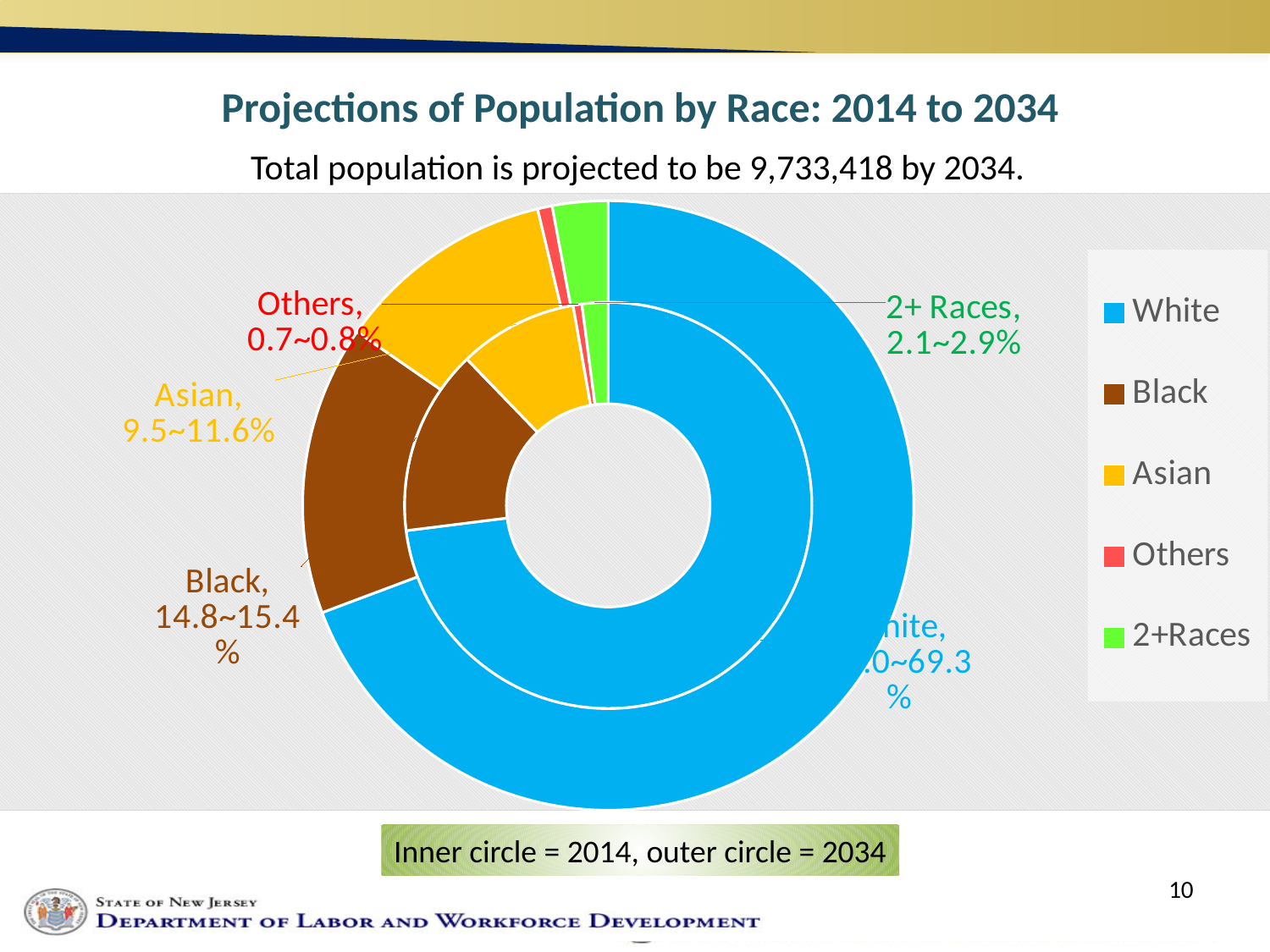
Which year does the inner circle of the chart represent? 2014 What value range is labelled for Others in the chart? 0.7~0.8% What value range is labelled for Black in the chart? 14.8~15.4% What value range is labelled for Asian in the chart? 9.5~11.6% Which race category has the smallest share of the population in the chart? Others How many race categories are shown in the chart? 5 How many entries does the chart legend list? 5 What kind of chart is shown on the slide? Doughnut chart What is the title of the chart on the slide? Projections of Population by Race: 2014 to 2034 Which race category has the largest share of the population in the chart? White Which has a larger share of the population, Black or Asian? Black What value range is labelled for 2+ Races in the chart? 2.1~2.9%